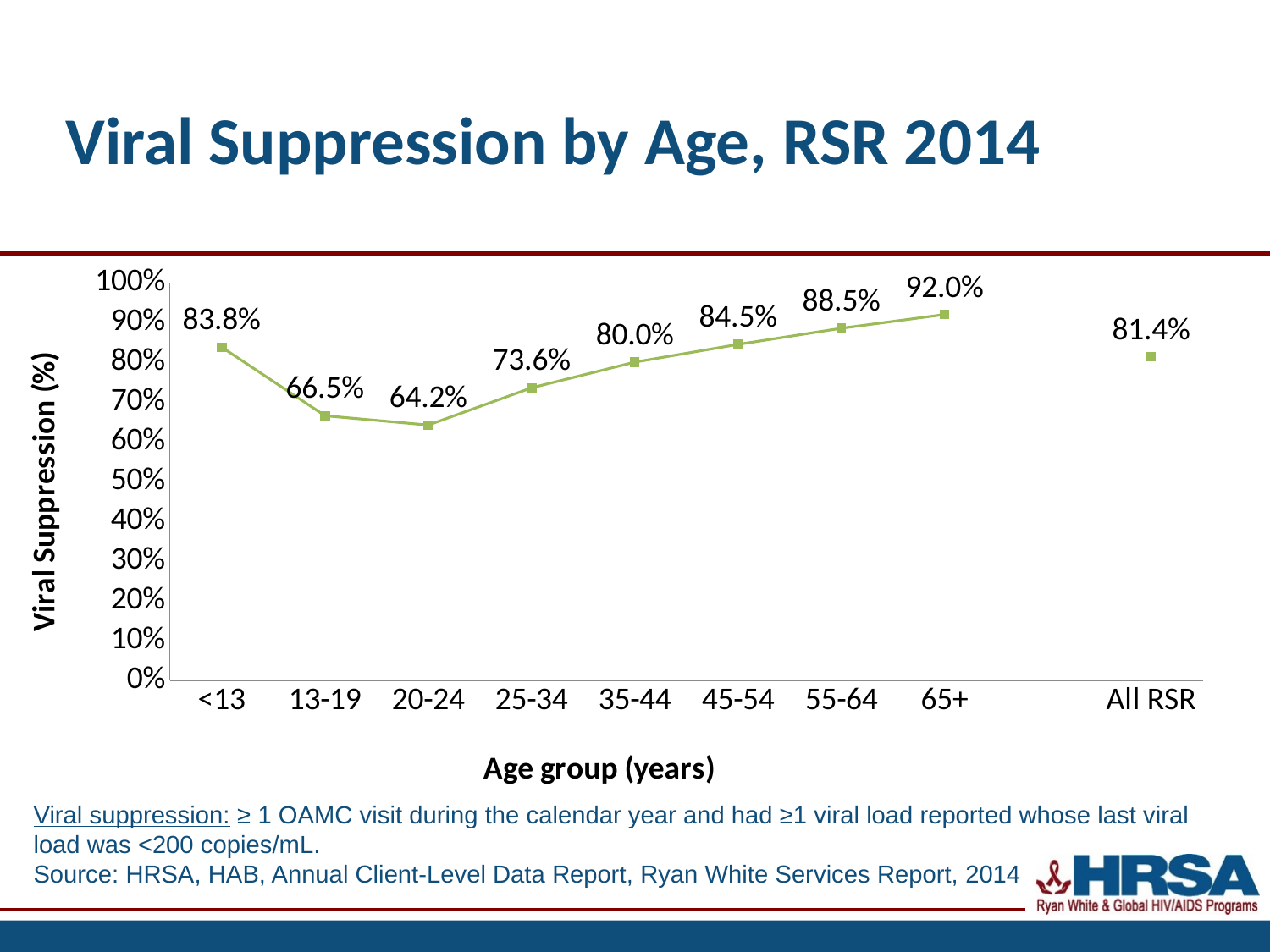
What is the viral suppression percentage for the <13 age group? 83.8% What kind of chart is shown on the slide? Line chart Which age group has the lowest viral suppression percentage? 20-24 What is the viral suppression percentage for the 20-24 age group? 64.2% Is the viral suppression value for the 35-44 age group greater or less than 70%? greater From the 20-24 age group to the 65+ age group, do the viral suppression values rise or fall? Rise Which age group has the highest viral suppression percentage? 65+ What is the viral suppression percentage for All RSR? 81.4% What is the difference in viral suppression between the 65+ and 20-24 age groups? 27.8 percentage points Which has a higher viral suppression percentage, the 13-19 age group or the 25-34 age group? 25-34 How many age group categories are plotted on the x axis, including All RSR? 9 What is the title of the chart? Viral Suppression by Age, RSR 2014